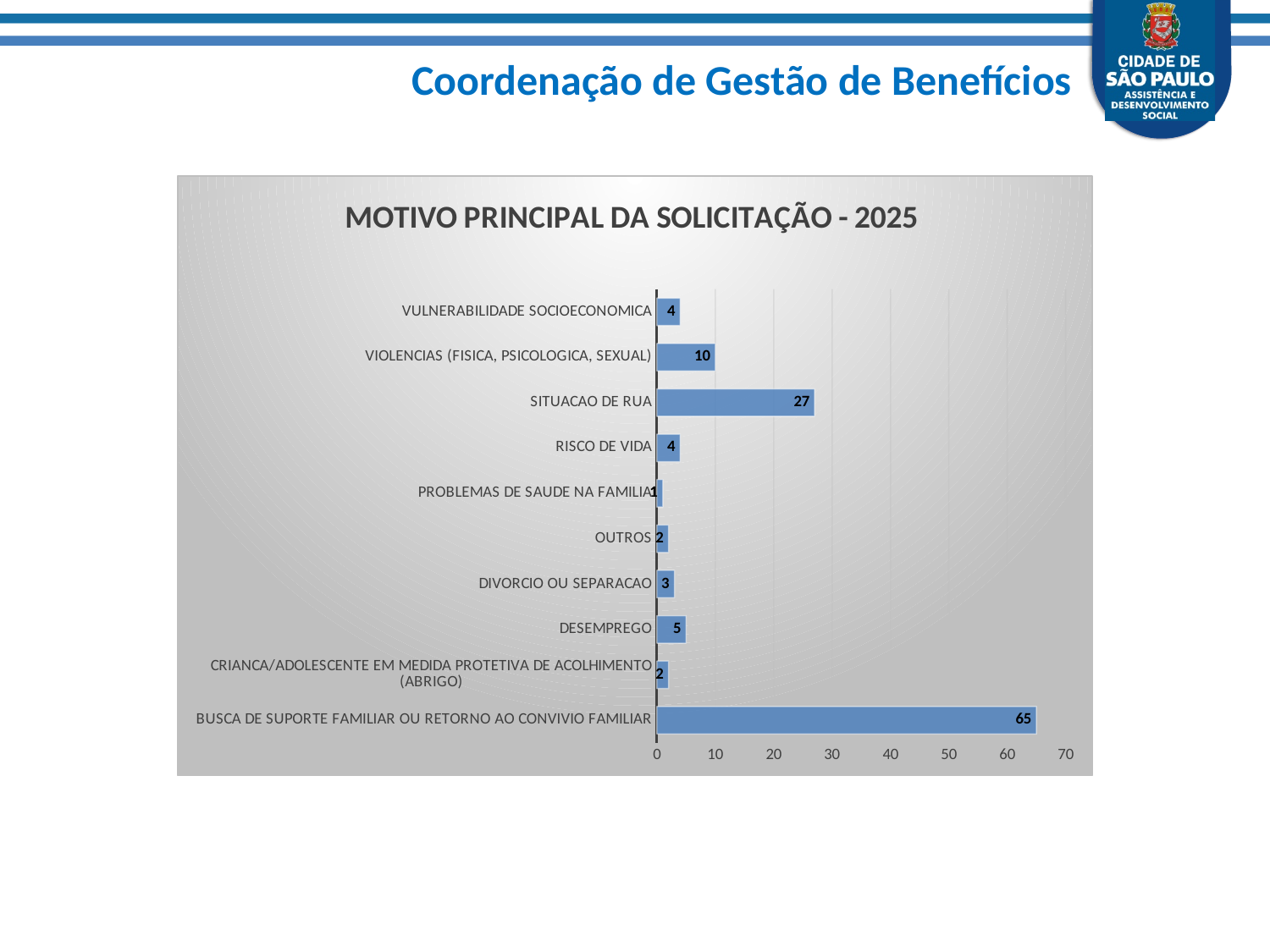
What is the value for DIVORCIO OU SEPARACAO? 3 Which category has the lowest value? PROBLEMAS DE SAUDE NA FAMILIA What is the value for DESEMPREGO? 5 Which category has the highest value? BUSCA DE SUPORTE FAMILIAR OU RETORNO AO CONVIVIO FAMILIAR What is the value for VIOLENCIAS (FISICA, PSICOLOGICA, SEXUAL)? 10 What is the value for SITUACAO DE RUA? 27 What is the title of the chart? MOTIVO PRINCIPAL DA SOLICITAÇÃO - 2025 Which is larger, the value for VIOLENCIAS (FISICA, PSICOLOGICA, SEXUAL) or the value for DESEMPREGO? VIOLENCIAS (FISICA, PSICOLOGICA, SEXUAL) What kind of chart is shown? bar chart Is the value for BUSCA DE SUPORTE FAMILIAR OU RETORNO AO CONVIVIO FAMILIAR greater or less than 60? greater What is the difference between the values for BUSCA DE SUPORTE FAMILIAR OU RETORNO AO CONVIVIO FAMILIAR and SITUACAO DE RUA? 38 How many categories are shown in the chart? 10